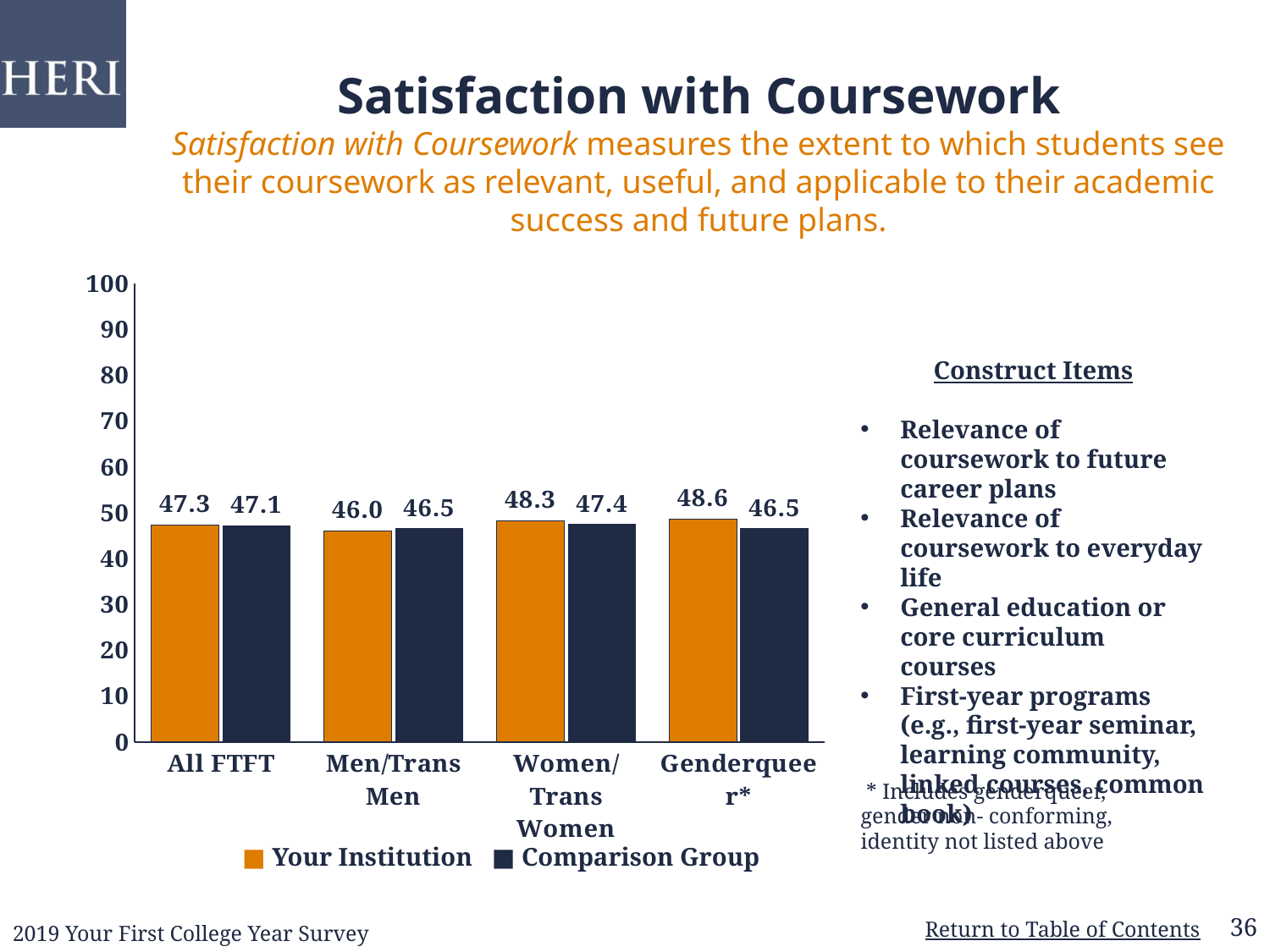
Which category has the highest Your Institution value? Genderqueer* What is the Comparison Group value for Men/Trans Men? 46.5 What is the Comparison Group value for Women/Trans Women? 47.4 Is the Your Institution value for Women/Trans Women greater or less than 40? greater What kind of chart is shown on the slide? bar chart Which category has the lowest Your Institution value? Men/Trans Men For Men/Trans Men, which is larger: Your Institution or Comparison Group? Comparison Group How many categories are shown on the x axis? 4 What is the Your Institution value for All FTFT? 47.3 What is the Your Institution value for Genderqueer*? 48.6 How many series does the legend list? 2 What is the difference between the Your Institution and Comparison Group values for Genderqueer*? 2.1